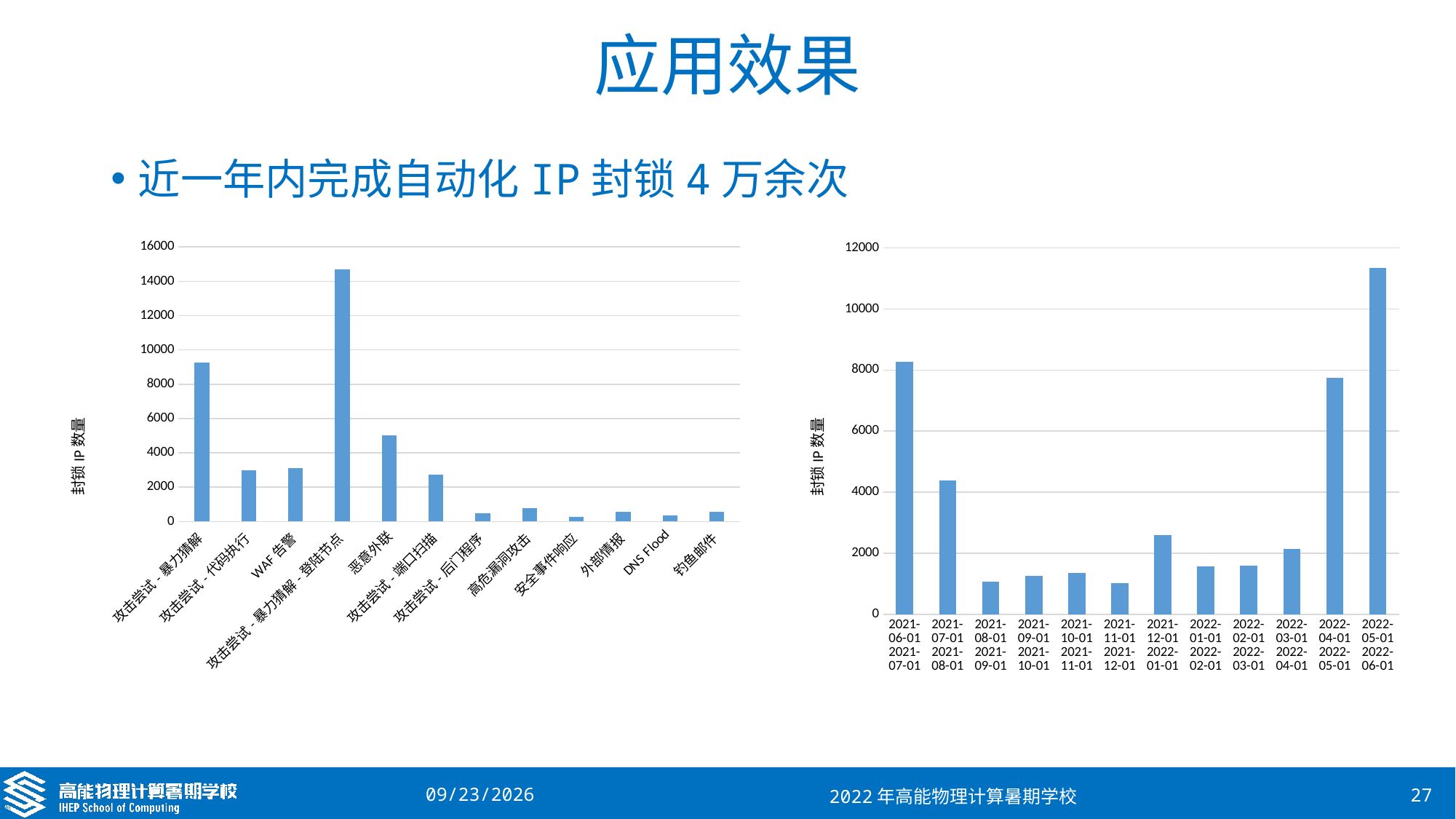
How many periods are shown on the x axis of the right chart? 12 What kind of chart is the chart on the right of the slide? bar chart In the left chart, is the value for 攻击尝试 - 暴力猜解 greater or less than 8000? greater In the left chart, which is larger, the value for 攻击尝试 - 暴力猜解 or the value for 恶意外联? 攻击尝试 - 暴力猜解 In the left chart, which category has the highest 封锁 IP 数量? 攻击尝试 - 暴力猜解 - 登陆节点 In the left chart, is the value for 恶意外联 greater or less than 6000? less In the right chart, which period has the highest 封锁 IP 数量? 2022-05-01 2022-06-01 In the right chart, which is larger, the value for 2022-04-01 2022-05-01 or the value for 2021-07-01 2021-08-01? 2022-04-01 2022-05-01 In the left chart, is the value for 攻击尝试 - 暴力猜解 - 登陆节点 greater or less than 14000? greater What kind of chart is the chart on the left of the slide? bar chart How many categories are shown on the x axis of the left chart? 12